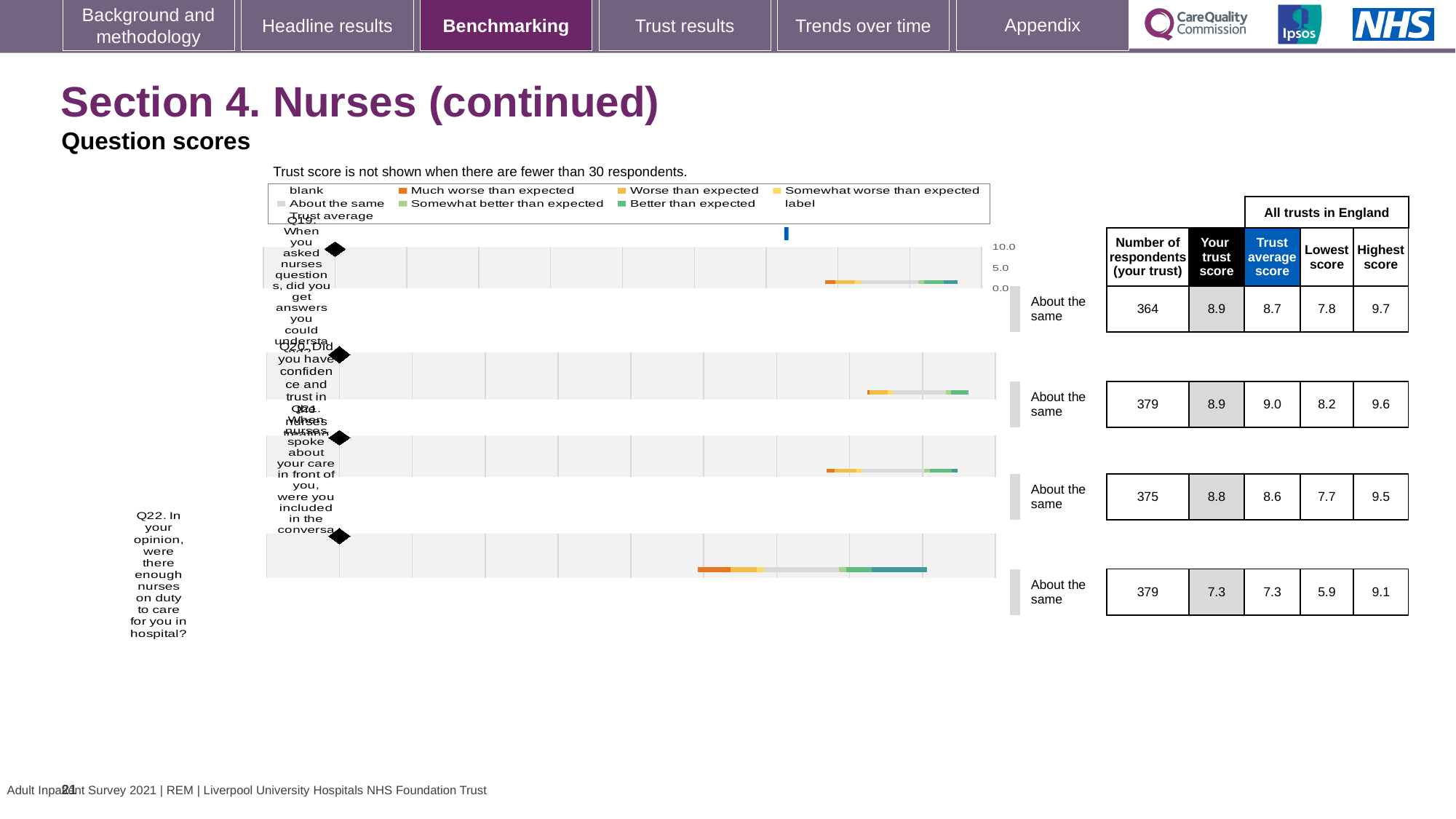
For Q20, which is larger: the trust's score or the trust average score? Trust average score How many questions are plotted on the chart? 4 What benchmark category is shown next to each of the four questions? About the same What is the difference between the highest and lowest scores in England for Q22? 3.2 What is the lowest score across all trusts in England for Q22? 5.9 Which question has the fewest respondents from the trust? Q19 Which question has the lowest trust score on this slide? Q22 What is the highest score across all trusts in England for Q20? 9.6 What kind of chart is used to show the question scores? Bar chart How many respondents from the trust answered Q19 (did you get answers you could understand)? 364 What is the trust's score for Q22 (were there enough nurses on duty to care for you in hospital)? 7.3 What is the difference between the trust's score and the trust average score for Q19? 0.2